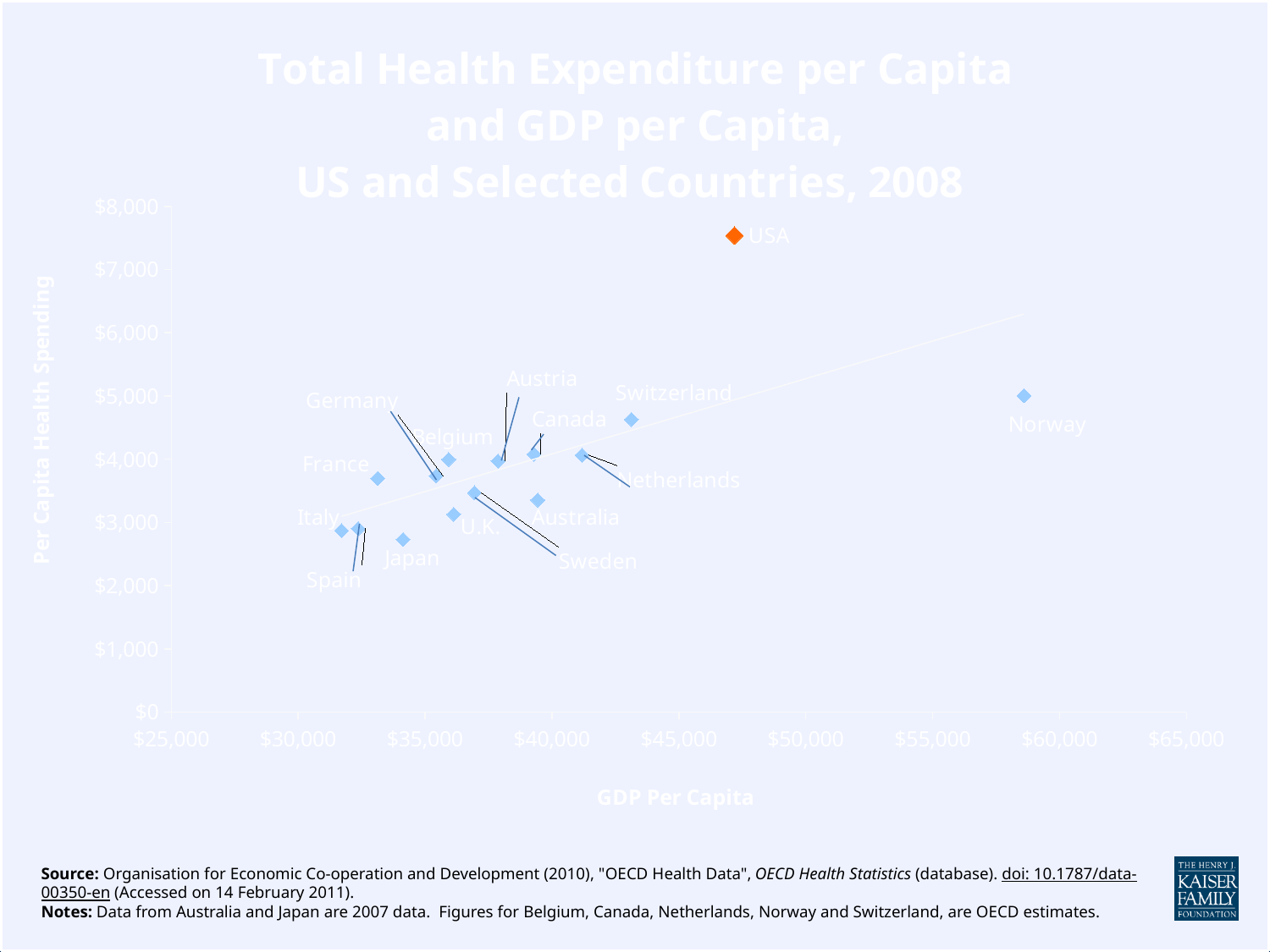
Which country's point is shown in orange rather than light blue? USA Is the per capita health spending for Japan greater or less than $3,000? less Does per capita health spending generally rise or fall as GDP per capita increases? Rise How many countries are plotted on the chart? 15 Which country has the highest per capita health spending? USA Is the per capita health spending for the USA greater or less than $7,000? greater Is the GDP per capita for Norway greater or less than $55,000? greater Which has higher GDP per capita, Norway or the USA? Norway Which has higher per capita health spending, Switzerland or Canada? Switzerland Which country has the highest GDP per capita? Norway What kind of chart is shown on the slide? Scatter chart Which country has the lowest GDP per capita? Italy